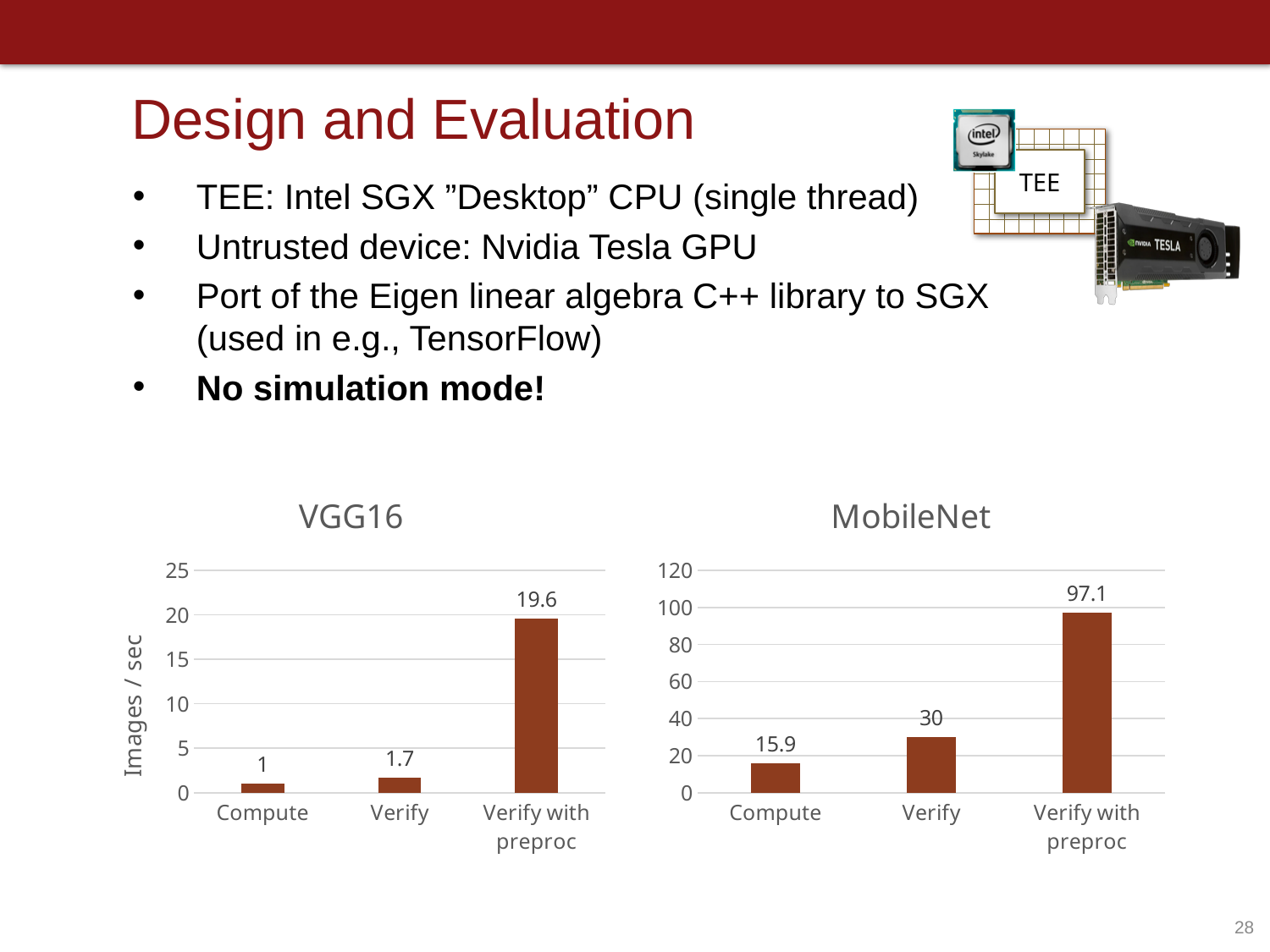
What kind of chart is the VGG16 chart? bar chart In the VGG16 chart, is the value for Verify with preproc greater or less than 15? greater In the VGG16 chart, which category has the highest value? Verify with preproc In the MobileNet chart, what is the difference between Verify with preproc and Verify? 67.1 How many categories does the MobileNet chart show? 3 In the MobileNet chart, what is the value for Compute? 15.9 In the MobileNet chart, which is larger, Compute or Verify? Verify In the VGG16 chart, what is the value for Verify with preproc? 19.6 In the VGG16 chart, what is the difference between Verify and Compute? 0.7 What is the y-axis label of the VGG16 chart? Images / sec In the MobileNet chart, which category has the lowest value? Compute In the MobileNet chart, what is the value for Verify? 30